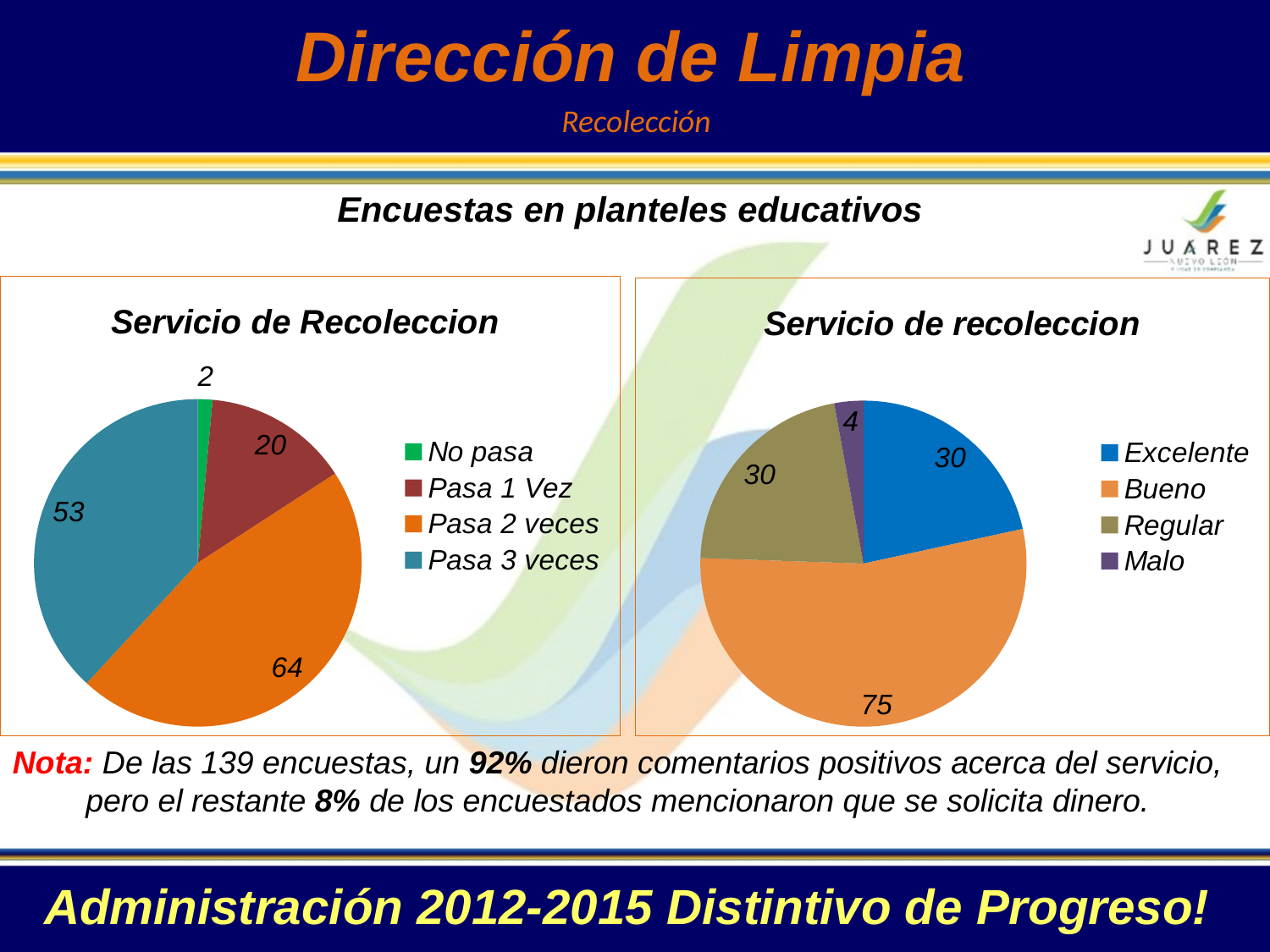
What type of chart is the left chart titled Servicio de Recoleccion? Pie chart In the right pie chart (Servicio de recoleccion), what is the value for Malo? 4 How many categories does the legend of the right pie chart (Servicio de recoleccion) list? 4 In the left pie chart (Servicio de Recoleccion), which category has the largest slice? Pasa 2 veces In the left pie chart (Servicio de Recoleccion), what is the value for No pasa? 2 In the left pie chart (Servicio de Recoleccion), which is larger: Pasa 1 Vez or Pasa 3 veces? Pasa 3 veces In the right pie chart (Servicio de recoleccion), which category has the smallest slice? Malo In the left pie chart (Servicio de Recoleccion), what is the value for Pasa 2 veces? 64 In the right pie chart (Servicio de recoleccion), what is the difference between Bueno and Excelente? 45 In the right pie chart (Servicio de recoleccion), what is the value for Bueno? 75 In the left pie chart (Servicio de Recoleccion), what is the difference between Pasa 2 veces and Pasa 3 veces? 11 In the right pie chart (Servicio de recoleccion), what colour is the Excelente slice? Blue